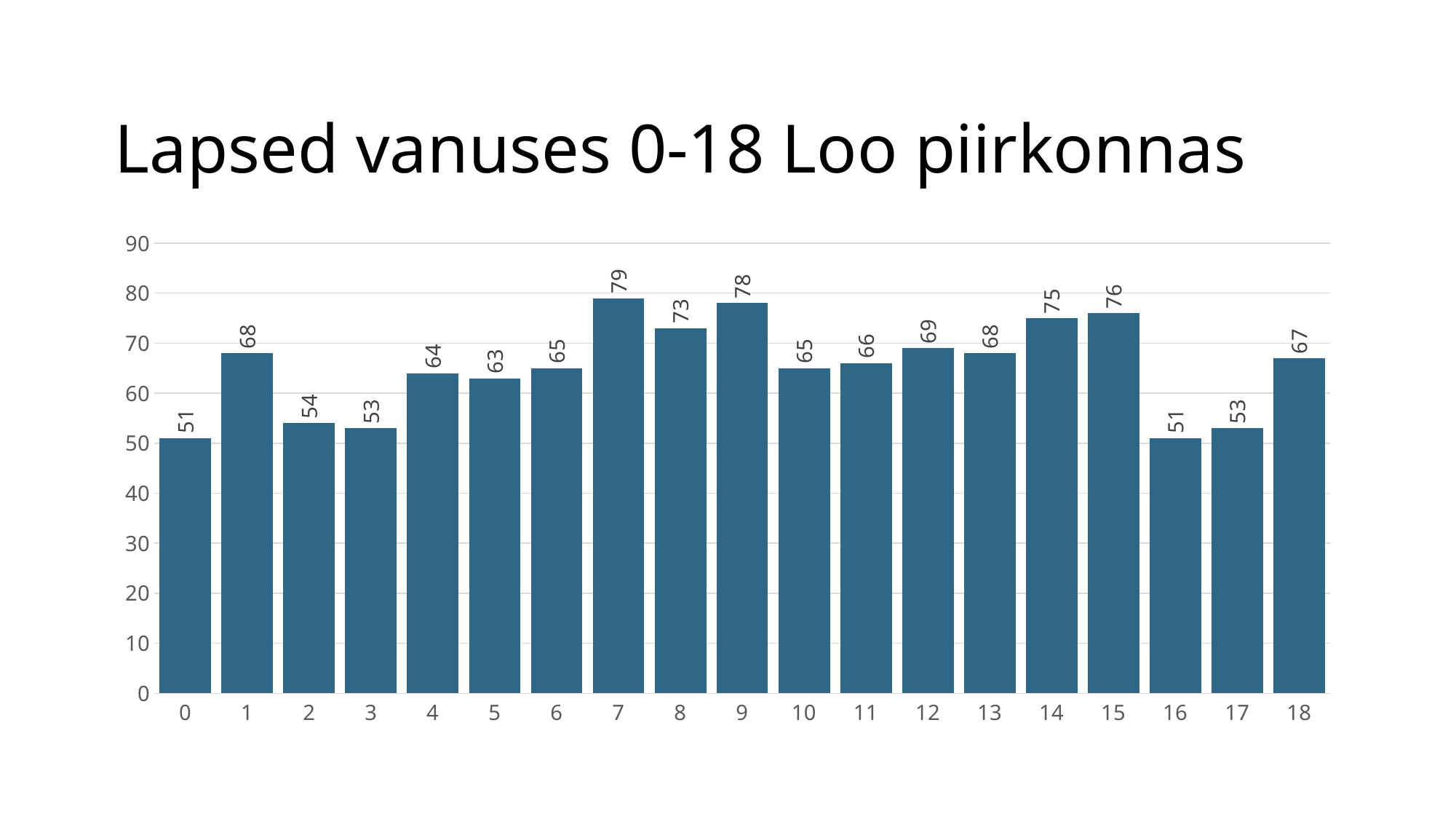
What kind of chart is shown on the slide? bar chart Which age has the highest value? 7 How many age categories are shown on the x axis? 19 What is the title of the chart? Lapsed vanuses 0-18 Loo piirkonnas What is the lowest value shown on the chart? 51 Is the value for age 8 greater or less than 70? greater Which is larger, the value for age 9 or the value for age 14? age 9 What is the value for age 18? 67 What is the difference between the values for age 7 and age 0? 28 What is the value for age 7? 79 What is the value for age 12? 69 What is the difference between the values for age 15 and age 16? 25